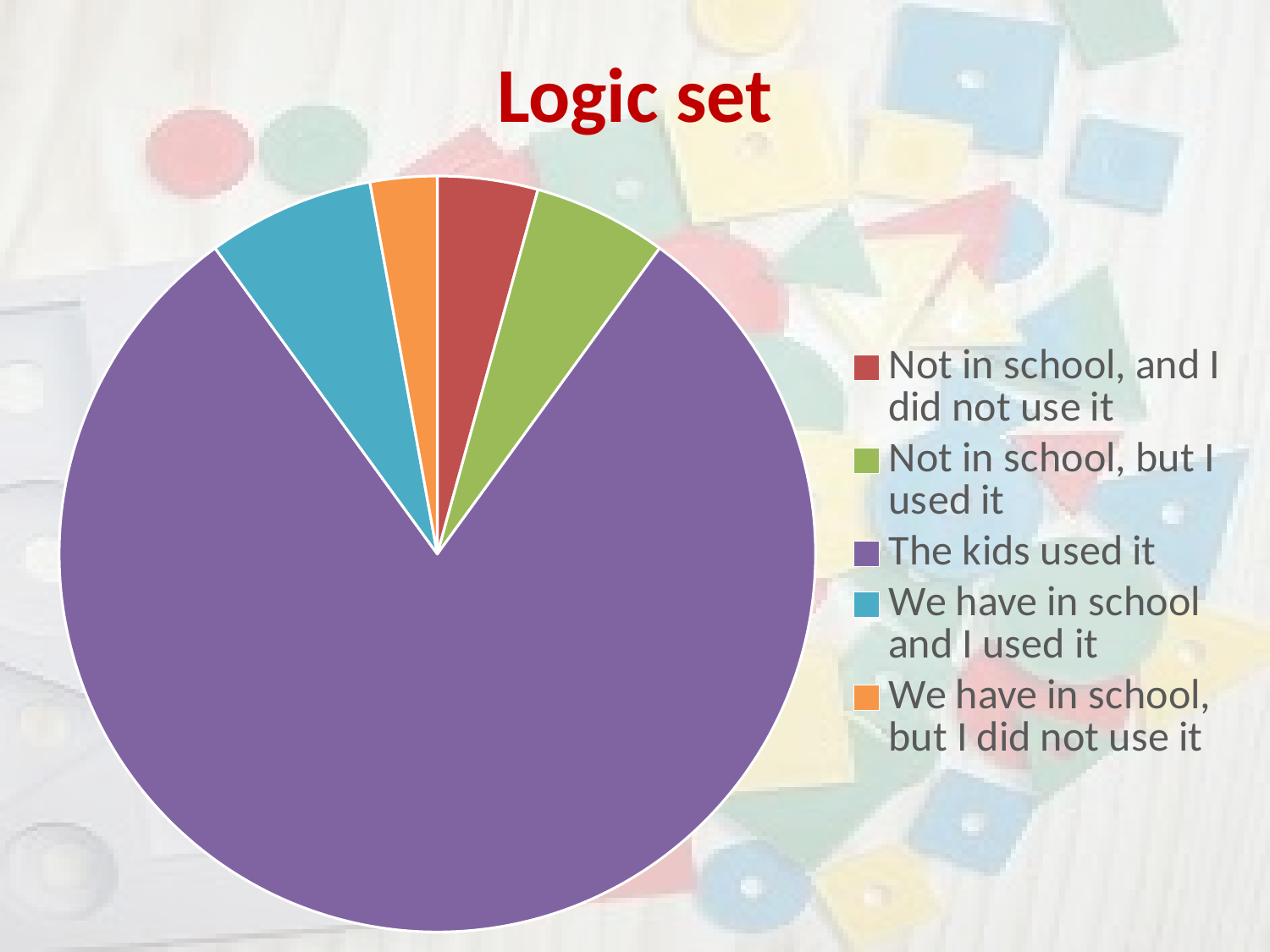
What colour is the slice for "The kids used it"? purple How many slices does the pie chart have? 5 Which slice is larger: "We have in school and I used it" or "Not in school, and I did not use it"? We have in school and I used it What is the title of the chart? Logic set Which slice is larger: "The kids used it" or "Not in school, but I used it"? The kids used it Which category has the largest slice of the pie? The kids used it How many entries does the legend list? 5 Which slice is larger: "We have in school and I used it" or "We have in school, but I did not use it"? We have in school and I used it What kind of chart is shown on the slide? pie chart Which category has the smallest slice of the pie? We have in school, but I did not use it